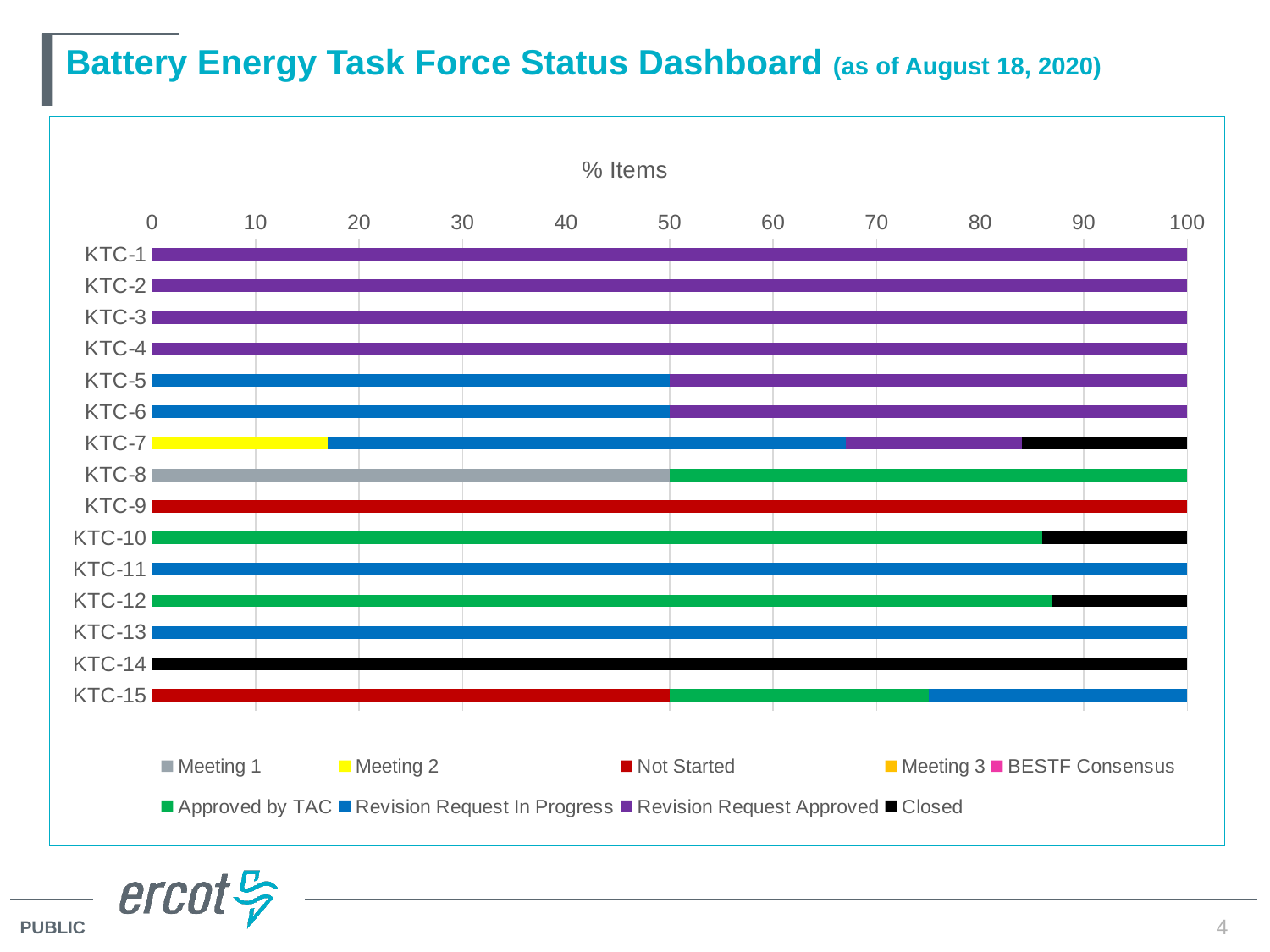
What is the total of the stacked bar for KTC-1? 100 What is the title of the chart? % Items How many series does the chart legend list? 9 Is the value of Approved by TAC for KTC-10 greater or less than 80? greater What kind of chart is shown on the slide? bar chart For KTC-15, which is larger: the Not Started segment or the Approved by TAC segment? Not Started What is the value of Meeting 1 for KTC-8? 50 What is the value of Revision Request In Progress for KTC-5? 50 Which series is shown in black on the chart? Closed Is the value of Meeting 2 for KTC-7 greater or less than 20? less Is the value of Revision Request In Progress for KTC-7 greater or less than 40? greater How many KTC categories are plotted on the chart? 15